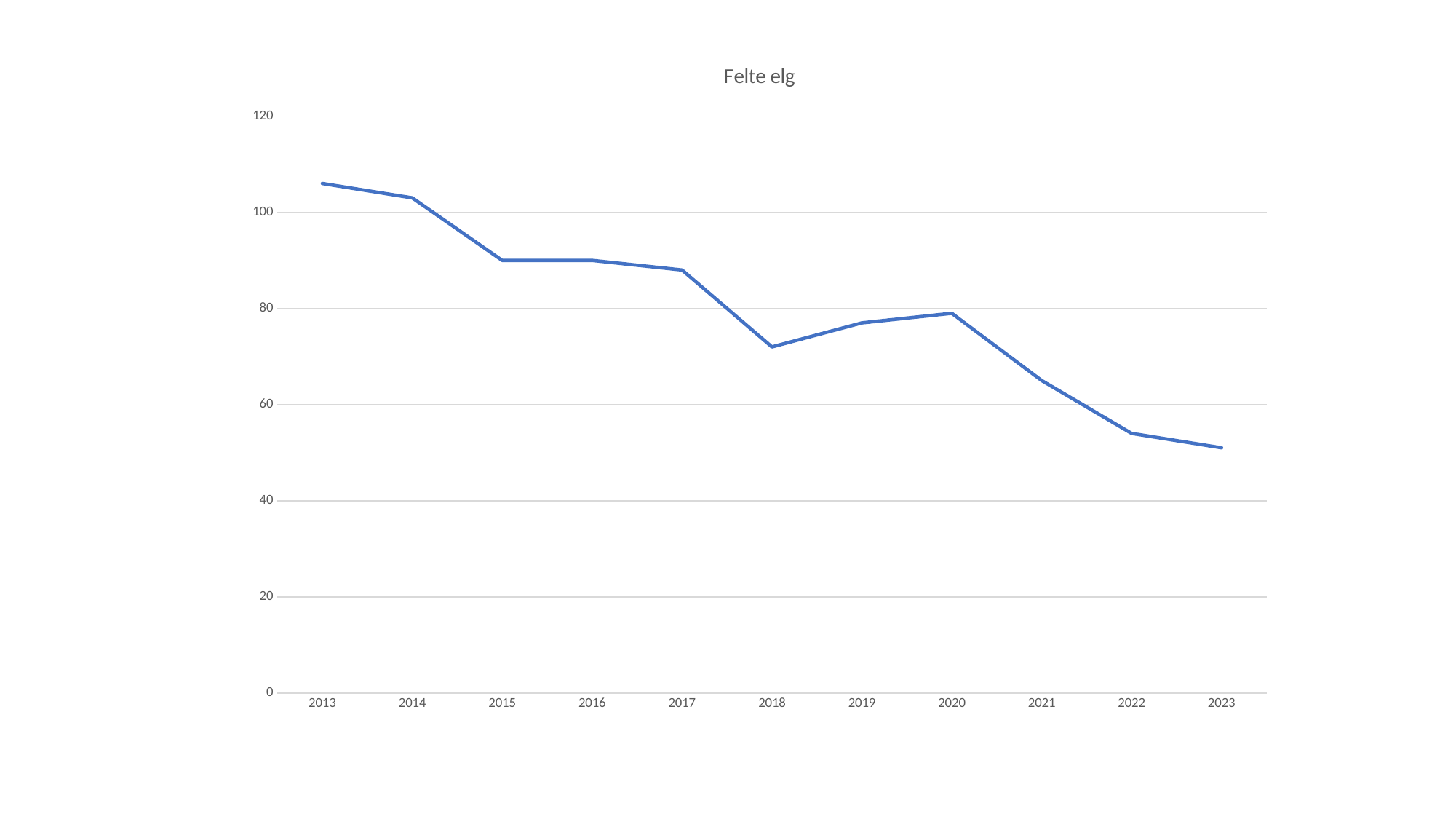
Do the values generally rise or fall from 2013 to 2023? fall Which year has the lowest value? 2023 Is the value for 2013 greater or less than 100? greater Which is larger, the value for 2018 or the value for 2020? 2020 Is the value for 2023 greater or less than 60? less Is the value for 2017 greater or less than 80? greater How many years are plotted along the x axis? 11 Which year has the highest value? 2013 Which is larger, the value for 2017 or the value for 2021? 2017 What is the title of the chart? Felte elg What kind of chart is shown on the slide? line chart